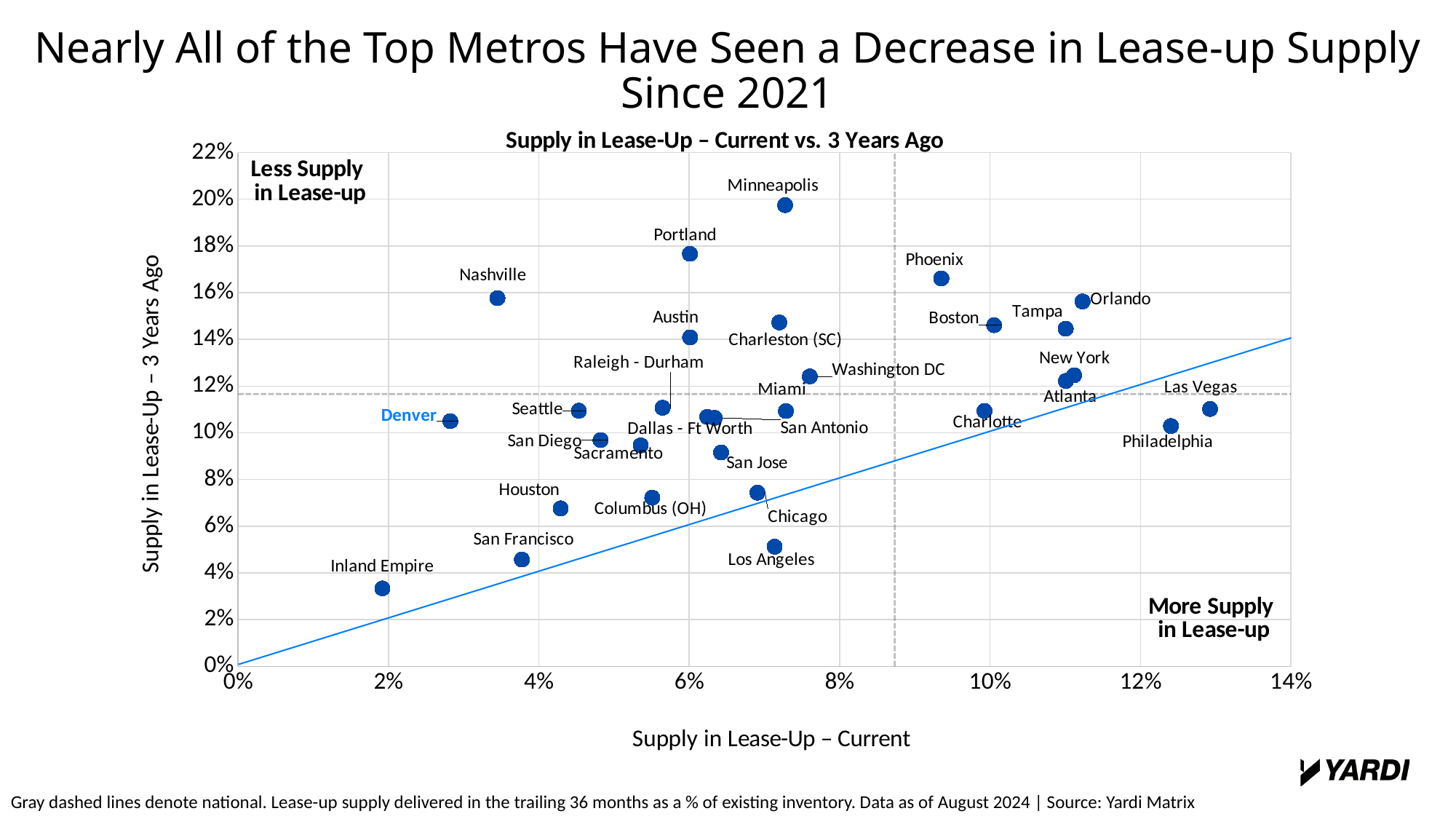
What is the title of the chart? Supply in Lease-Up – Current vs. 3 Years Ago Which metro has the lowest current supply in lease-up? Inland Empire What kind of chart is shown on the slide? Scatter chart Which metro had the highest supply in lease-up 3 years ago? Minneapolis According to the footnote, what do the gray dashed lines denote? National Is the current supply in lease-up for Las Vegas greater or less than 12%? greater Which metro has the highest current supply in lease-up? Las Vegas Which metro had the lowest supply in lease-up 3 years ago? Inland Empire Which metro had higher supply in lease-up 3 years ago, Phoenix or Boston? Phoenix Is the supply in lease-up 3 years ago for Minneapolis greater or less than 18%? greater Which metro had higher supply in lease-up 3 years ago, Portland or Nashville? Portland Is the supply in lease-up 3 years ago for Los Angeles greater or less than 6%? less